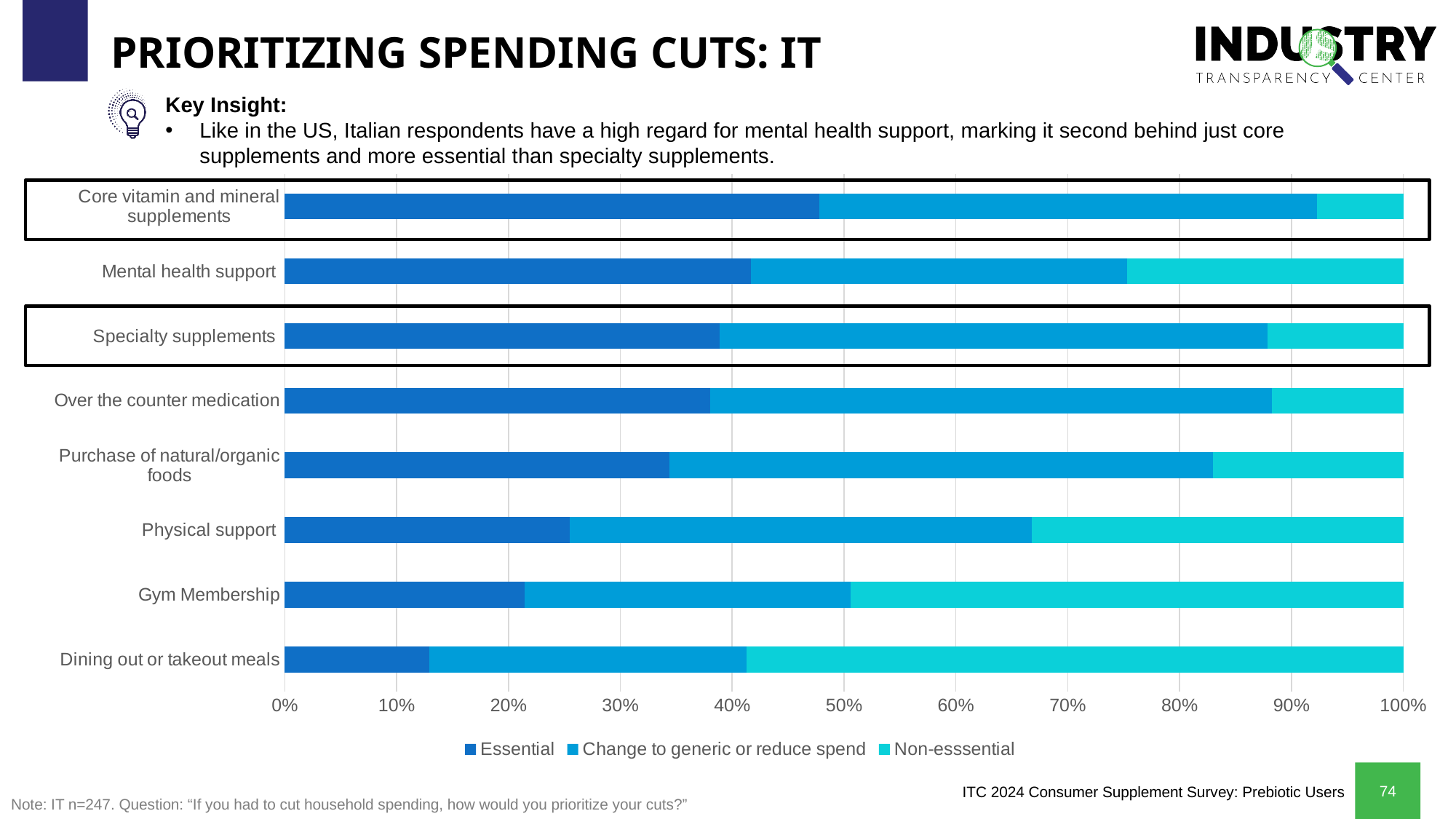
Which category has the smallest Essential share? Dining out or takeout meals Which category has the largest Non-esssential share? Dining out or takeout meals What is the title of the chart slide? PRIORITIZING SPENDING CUTS: IT Is the Essential share for Core vitamin and mineral supplements greater or less than 40%? greater Which category has the largest Essential share? Core vitamin and mineral supplements Which has a larger Essential share: Mental health support or Gym Membership? Mental health support Which has a larger Essential share: Purchase of natural/organic foods or Physical support? Purchase of natural/organic foods Is the Essential share for Gym Membership greater or less than 30%? less Is the Essential share for Dining out or takeout meals greater or less than 20%? less How many series does the legend list? 3 What kind of chart is shown on the slide? Stacked bar chart How many categories are plotted on the chart? 8